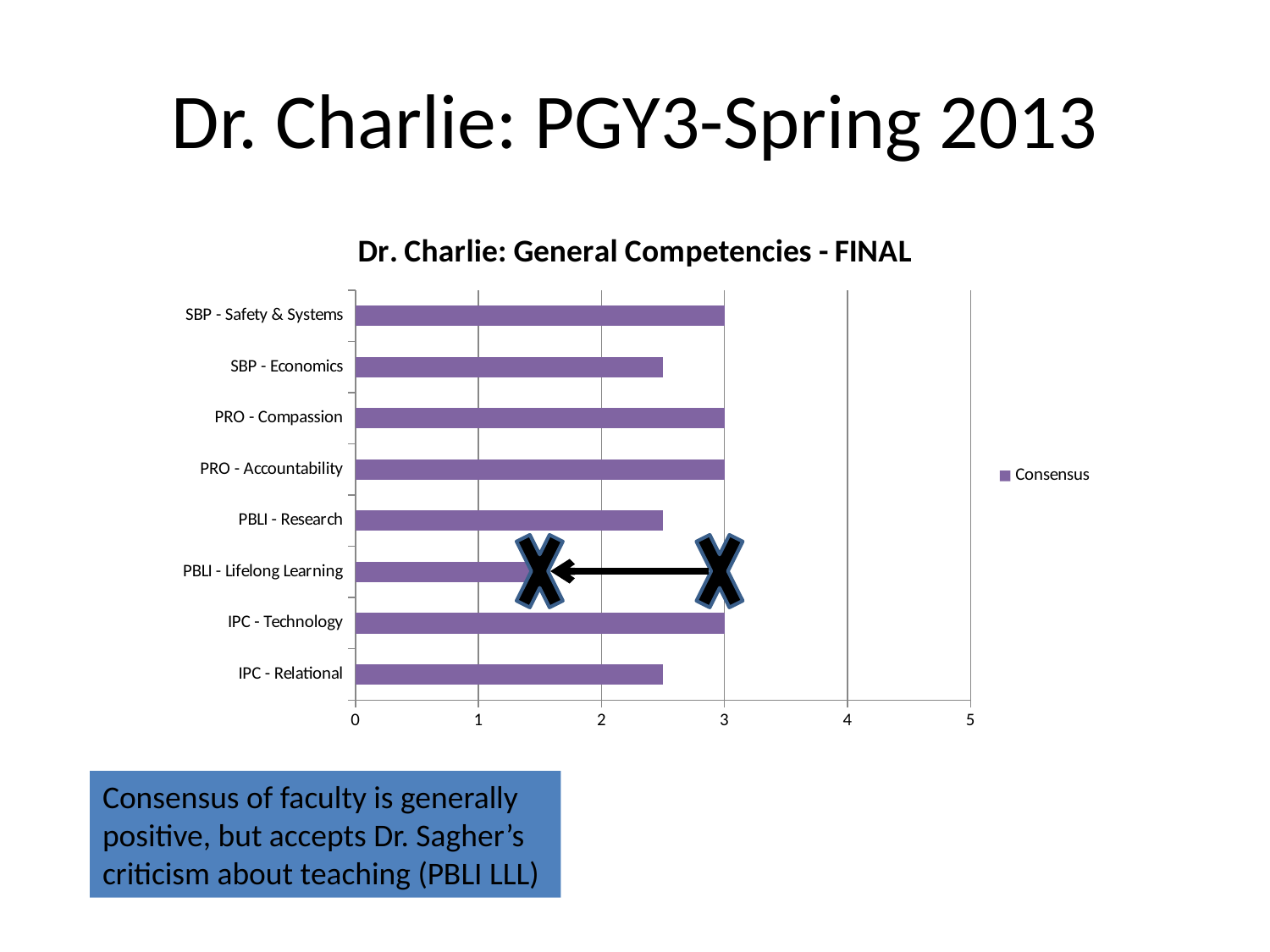
Is the value for PBLI - Lifelong Learning greater or less than 2? less Which is larger, the value for PRO - Compassion or the value for PBLI - Research? PRO - Compassion What is the title of the chart? Dr. Charlie: General Competencies - FINAL How many series does the legend list? 1 What kind of chart is shown on the slide? bar chart How many categories are plotted on the chart? 8 What is the value for SBP - Safety & Systems? 3 What series name appears in the legend? Consensus Is the value for SBP - Economics greater or less than 3? less Which category has the lowest value? PBLI - Lifelong Learning What is the value for IPC - Technology? 3 What is the value for PRO - Accountability? 3